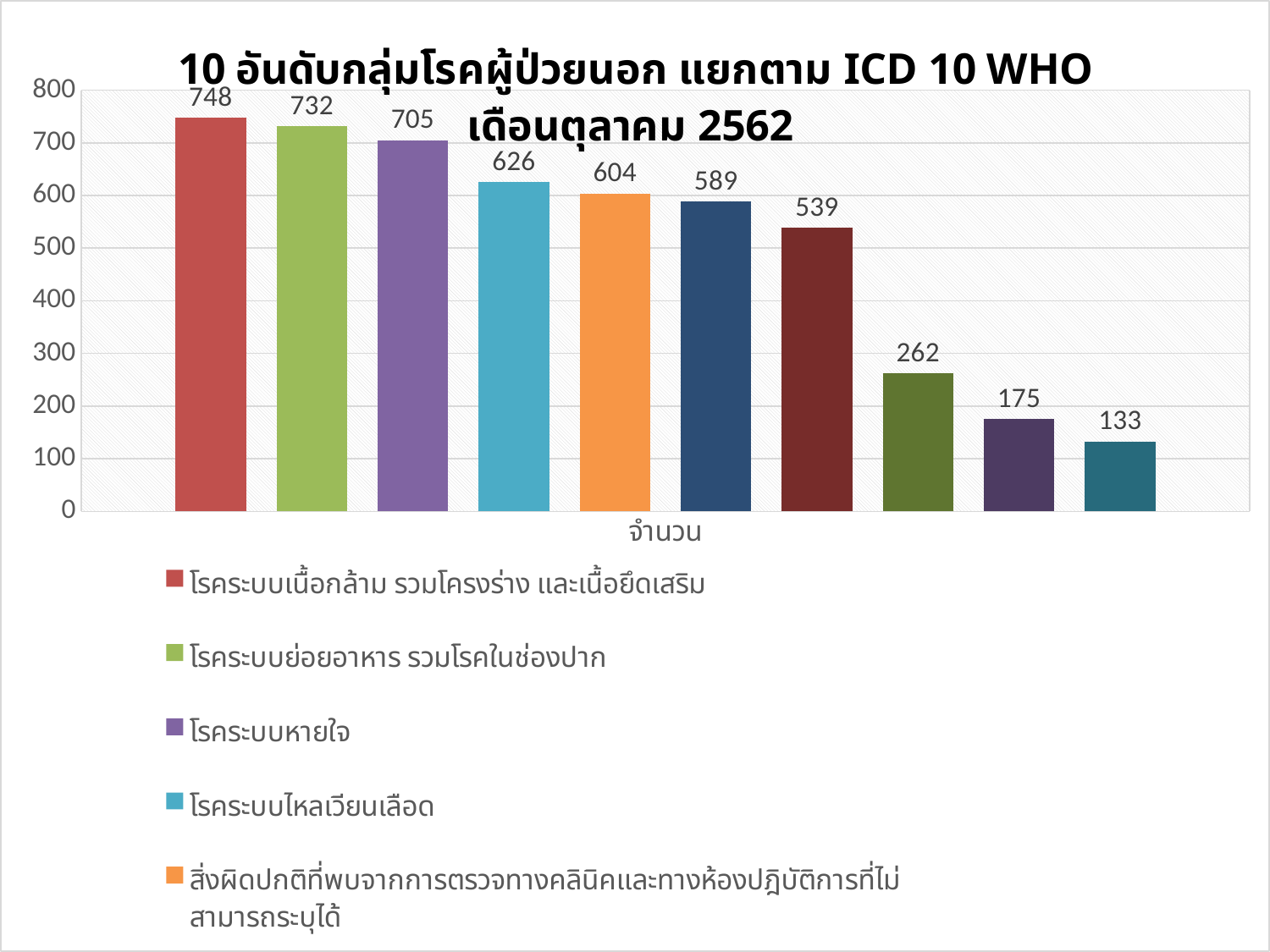
What is the value of the shortest bar in the chart? 133 Which disease group has the highest value? โรคระบบเนื้อกล้าม รวมโครงร่าง และเนื้อยึดเสริม How many bars are plotted in the chart? 10 What is the value for โรคระบบหายใจ? 705 What is the value for สิ่งผิดปกติที่พบจากการตรวจทางคลินิคและทางห้องปฏิบัติการที่ไม่สามารถระบุได้? 604 Do the bar values rise or fall from left to right across the chart? fall Is the value for โรคระบบไหลเวียนเลือด greater or less than 500? greater What is the difference between the values for โรคระบบเนื้อกล้าม รวมโครงร่าง และเนื้อยึดเสริม and โรคระบบย่อยอาหาร รวมโรคในช่องปาก? 16 What kind of chart is shown on the slide? bar chart What is the value for โรคระบบไหลเวียนเลือด? 626 Which is larger, the value for โรคระบบหายใจ or the value for โรคระบบไหลเวียนเลือด? โรคระบบหายใจ What is the value for โรคระบบย่อยอาหาร รวมโรคในช่องปาก? 732